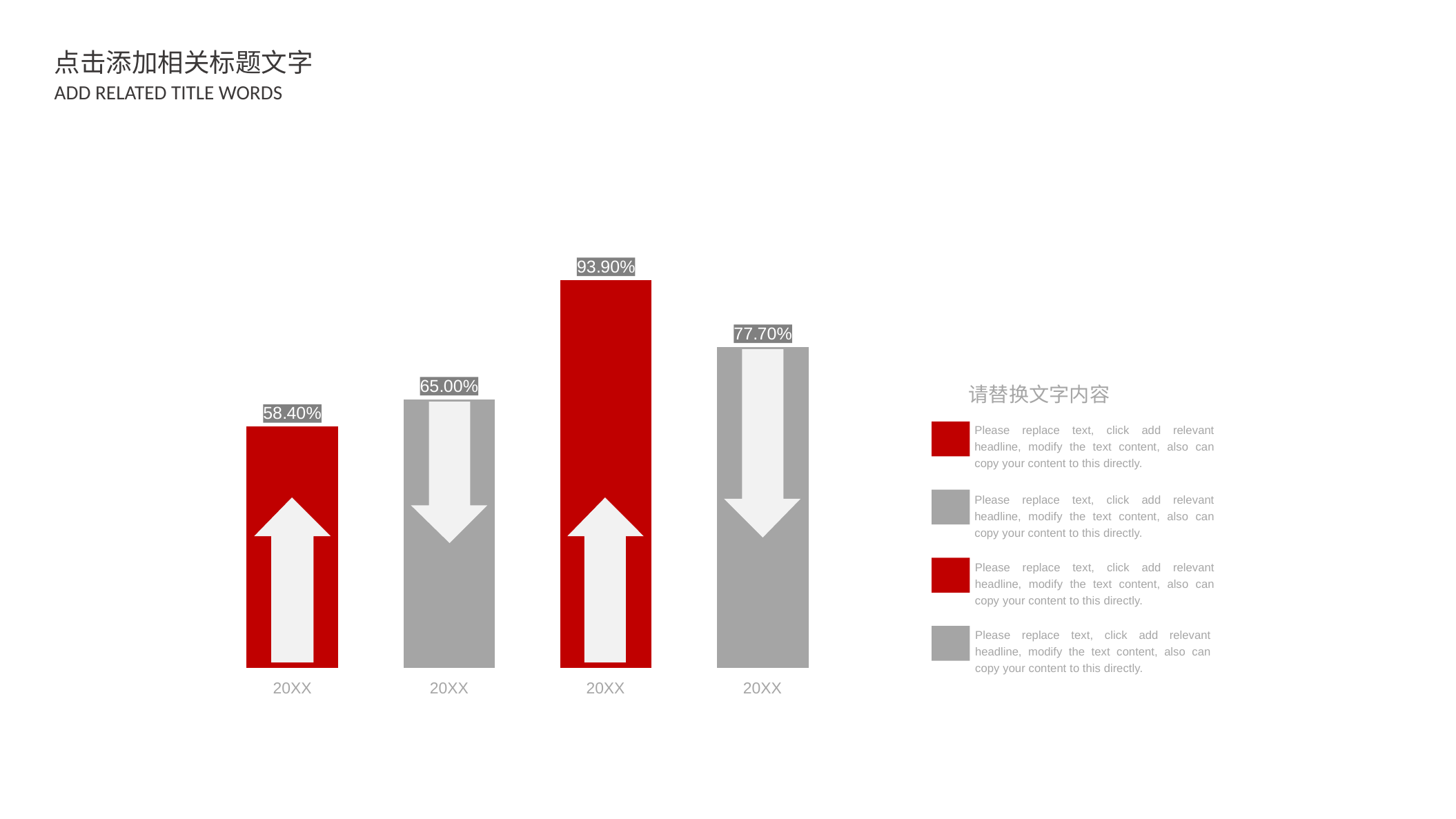
Which bar has the lowest value? The first bar from the left (58.40%) What is the difference between the third bar (93.90%) and the fourth bar (77.70%)? 16.20% What is the value shown on the third bar from the left? 93.90% What type of chart is shown on the slide? Bar chart What is the value shown on the second bar from the left? 65.00% What colour are the bars that contain an upward arrow? Red What is the value shown on the first bar from the left? 58.40% What is the value shown on the fourth bar from the left? 77.70% Which is larger, the value of the second bar or the value of the fourth bar? The fourth bar (77.70%) Which bar has the highest value? The third bar from the left (93.90%) How many bars are plotted in the chart? 4 What is the difference between the second bar (65.00%) and the first bar (58.40%)? 6.60%